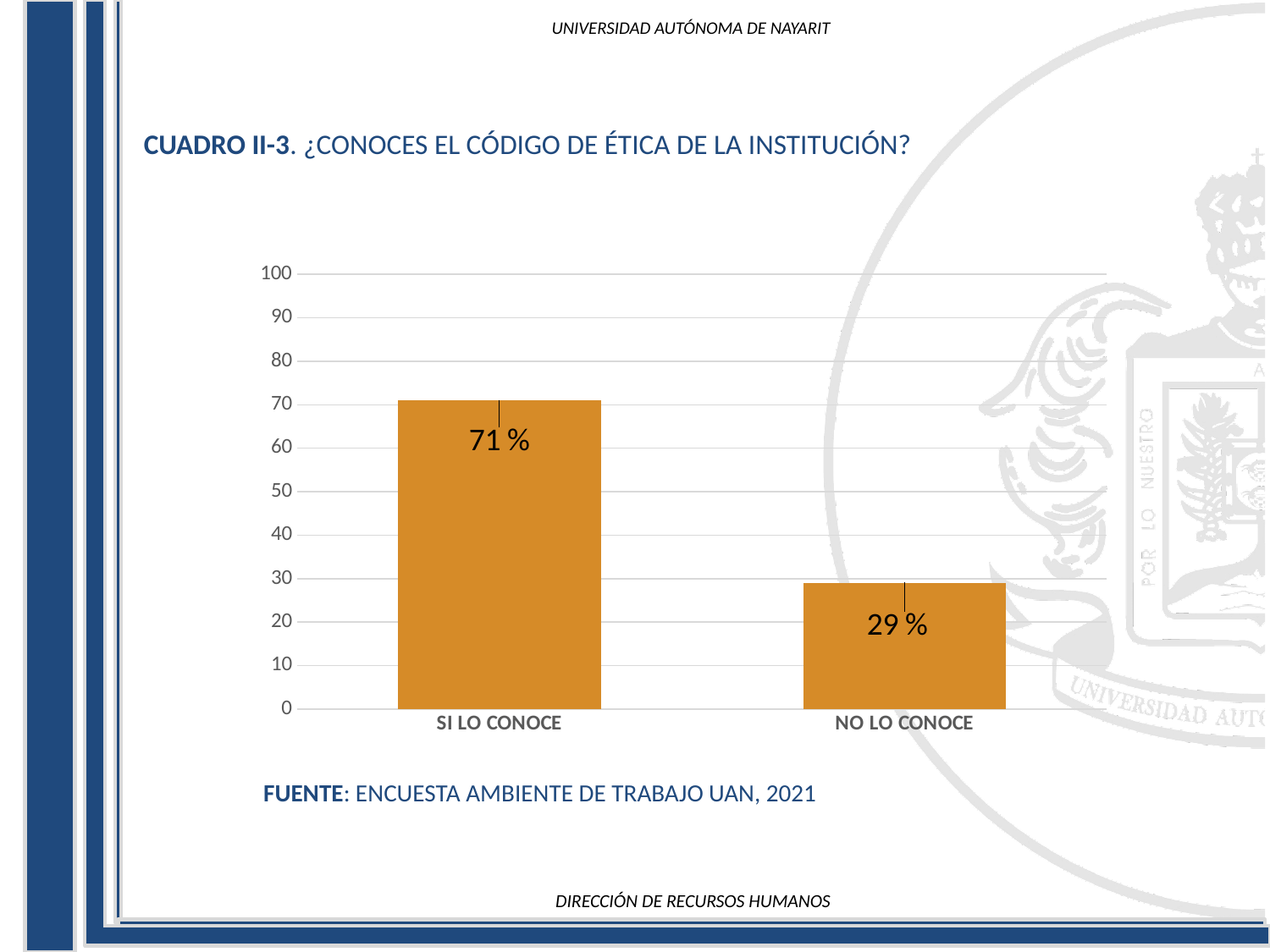
What is the title of the chart on the slide? CUADRO II-3. ¿CONOCES EL CÓDIGO DE ÉTICA DE LA INSTITUCIÓN? Which category has the lowest value? NO LO CONOCE Is the value for NO LO CONOCE greater or less than 40? less Which category has the highest value? SI LO CONOCE What is the difference between the values for SI LO CONOCE and NO LO CONOCE? 42 % What is the value for SI LO CONOCE? 71 % How many categories are shown on the x axis? 2 What is the source cited below the chart? ENCUESTA AMBIENTE DE TRABAJO UAN, 2021 Is the value for SI LO CONOCE greater or less than 60? greater Which is larger, the value for SI LO CONOCE or NO LO CONOCE? SI LO CONOCE What is the value for NO LO CONOCE? 29 % What kind of chart is shown on the slide? bar chart